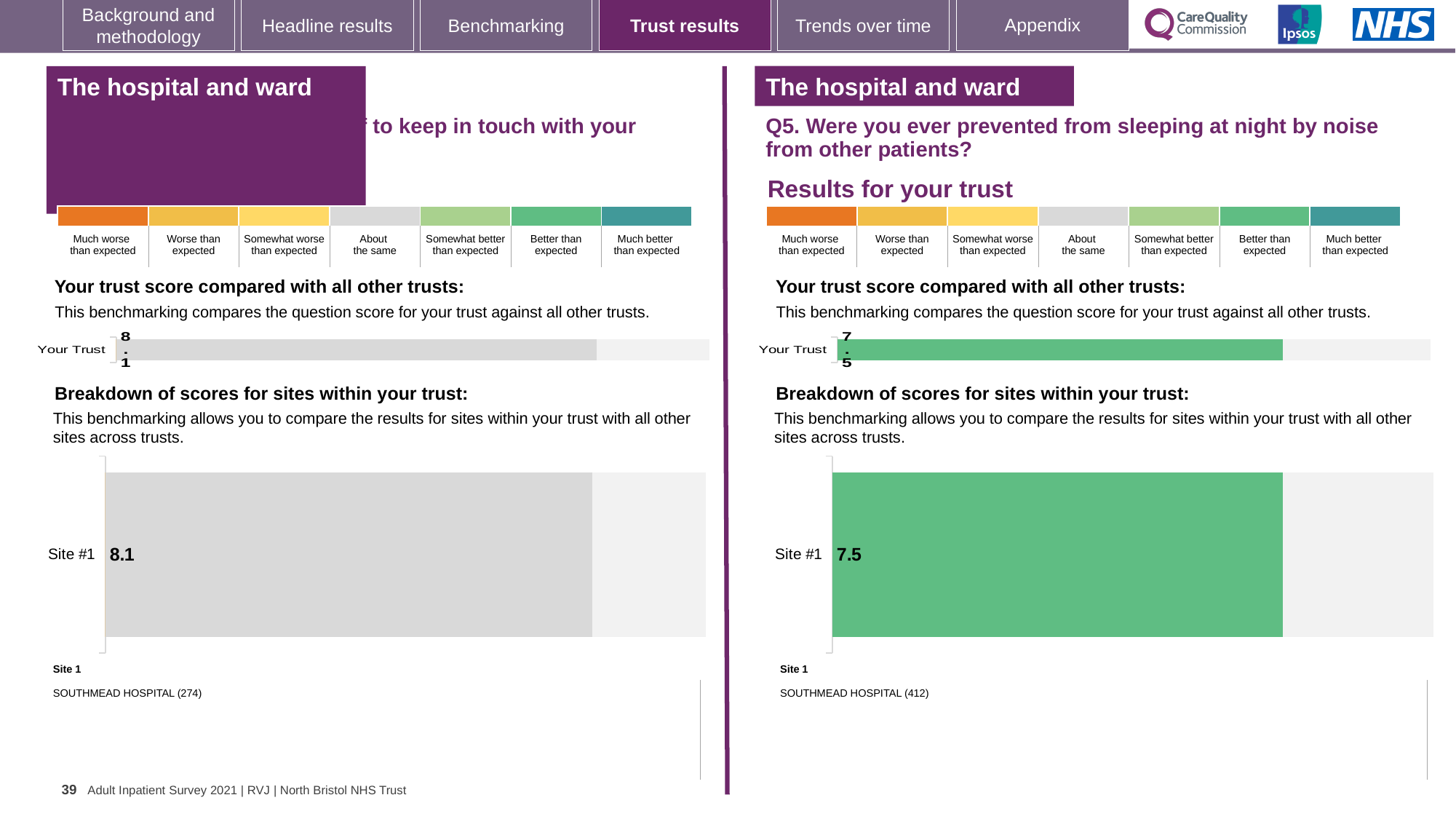
On the left-hand chart, what is the score for Your Trust? 8.1 On the right-hand chart for Q5 (prevented from sleeping at night by noise from other patients), what is the score for Your Trust? 7.5 Which is larger: the Your Trust score on the left-hand chart or the Your Trust score on the right-hand chart for Q5? Left-hand chart (8.1) On the right-hand chart for Q5, which benchmarking category does the green colour of the Your Trust bar correspond to? Better than expected On the right-hand chart for Q5, which hospital is listed as Site 1? SOUTHMEAD HOSPITAL (412) How many sites are shown in the breakdown of scores on the right-hand chart for Q5? 1 What is the difference between the Site #1 score on the left-hand chart and the Site #1 score on the right-hand chart for Q5? 0.6 On the left-hand chart, what is the score shown for Site #1? 8.1 On the right-hand chart for Q5, what is the score shown for Site #1? 7.5 What type of chart is used to show the Your Trust score on the right-hand chart for Q5? Bar chart How many sites are shown in the breakdown of scores on the left-hand chart? 1 On the left-hand chart, which benchmarking category does the grey colour of the Your Trust bar correspond to? About the same